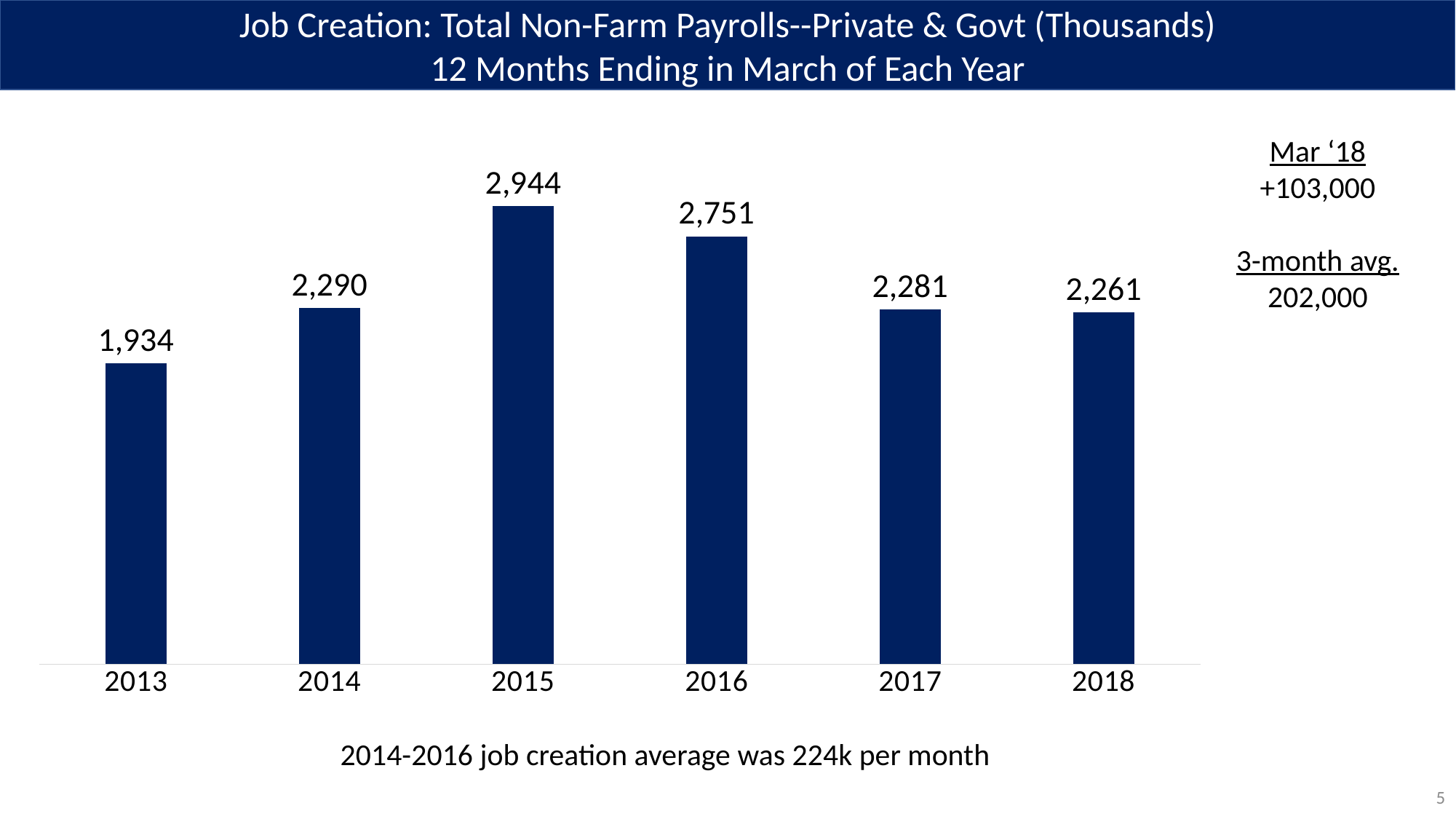
Which year has the highest value? 2015 What is the 3-month average shown to the right of the chart? 202,000 What is the value for 2013? 1,934 Which is larger, the value for 2014 or the value for 2016? 2016 How many years are shown on the chart? 6 What kind of chart is shown? bar chart What is the difference between the values for 2015 and 2016? 193 What is the difference between the values for 2014 and 2013? 356 What is the value for 2015? 2,944 What is the value for 2018? 2,261 Do the values rise or fall from 2016 to 2018? fall Which year has the lowest value? 2013